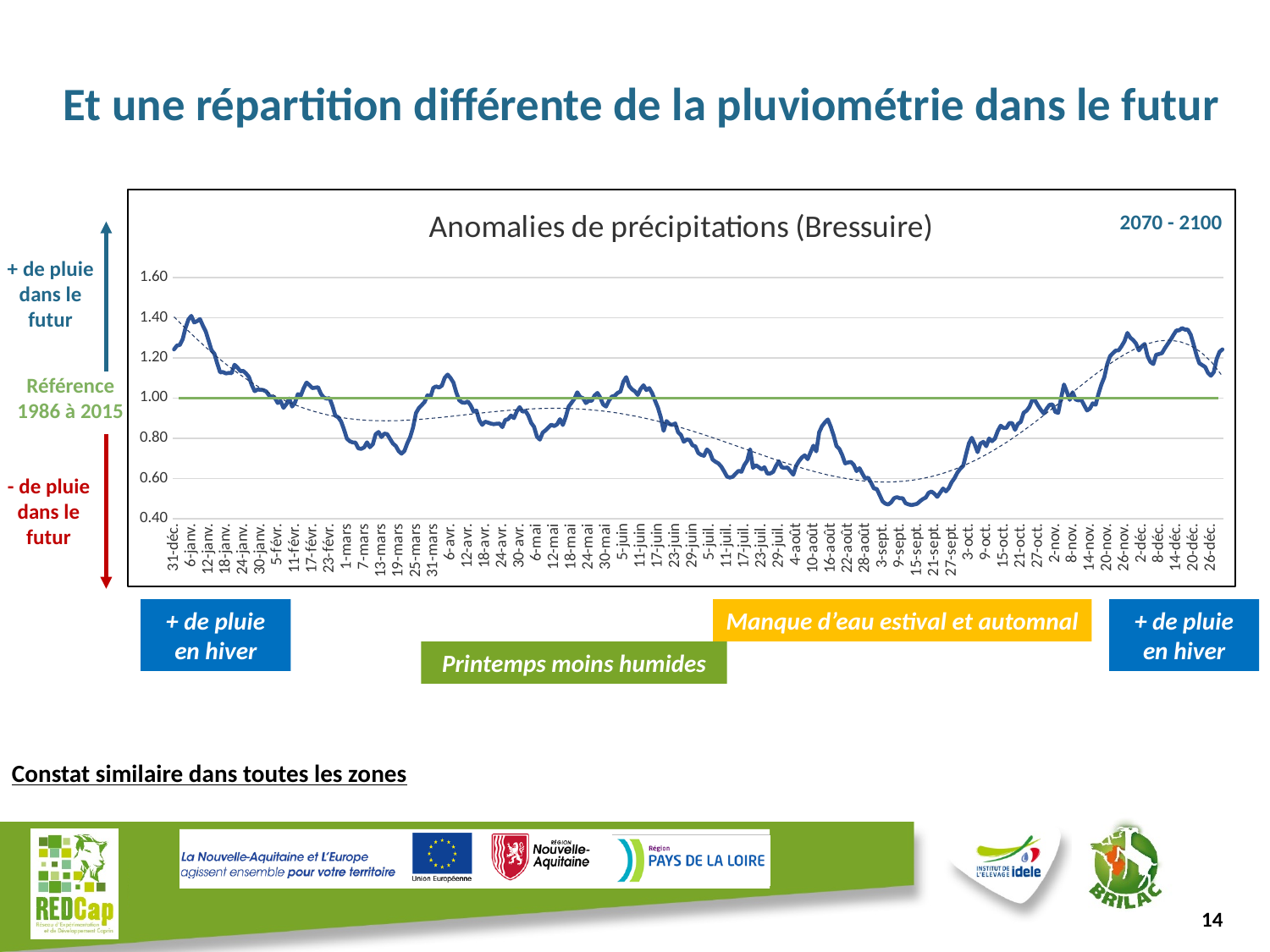
Is the value of the blue line at 12-janv. greater or less than 1.20? greater What is the title of the chart? Anomalies de précipitations (Bressuire) Does the blue line rise or fall between 31-déc. and 19-mars? fall Is the value of the blue line at 19-mars greater or less than 0.80? less Which future period is indicated in the top right corner of the chart? 2070 - 2100 At what value is the horizontal green reference line drawn? 1.00 Is the blue line higher at 12-janv. or at 3-sept.? 12-janv. Does the blue line rise or fall between 9-sept. and 14-déc.? rise Is the value of the blue line at 9-sept. greater or less than 0.60? less What kind of chart is shown on the slide? line chart